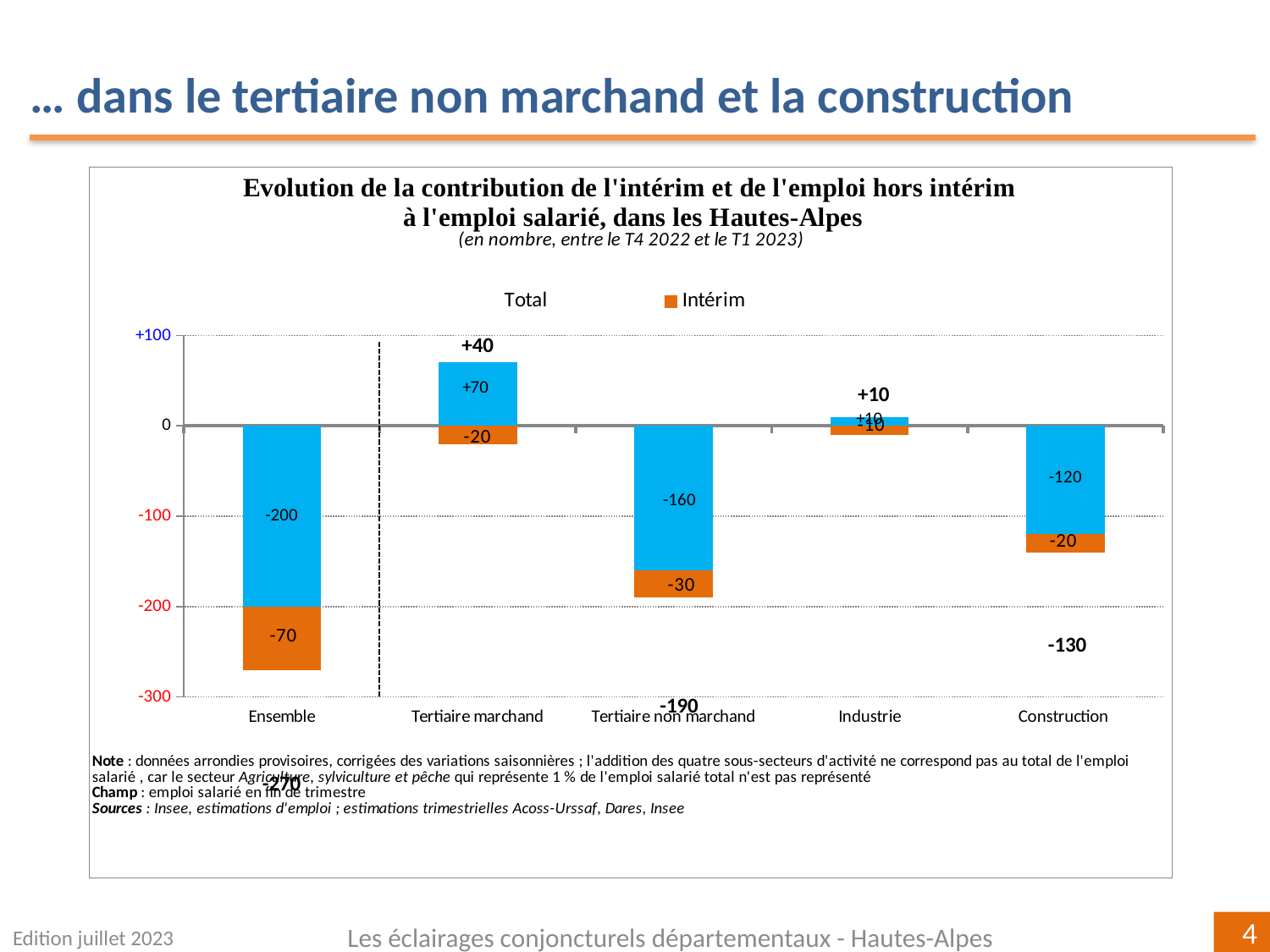
Which has the larger Intérim value, Tertiaire marchand or Tertiaire non marchand? Tertiaire marchand What is the difference between the Intérim values for Ensemble (-70) and Construction (-20)? 50 What total is labelled for Construction? -130 Which category has the lowest blue (non-Intérim) segment value? Ensemble What total is labelled above the bars for Tertiaire marchand? +40 What kind of chart is shown on the slide? Stacked bar chart How many categories are shown on the x axis? 5 What is the value of the blue (non-Intérim) segment for Tertiaire non marchand? -160 How many series does the legend list? 2 Which category has the highest total value? Tertiaire marchand What is the Intérim value for Ensemble? -70 What is the stacked total for Tertiaire non marchand (blue -160 plus Intérim -30)? -190